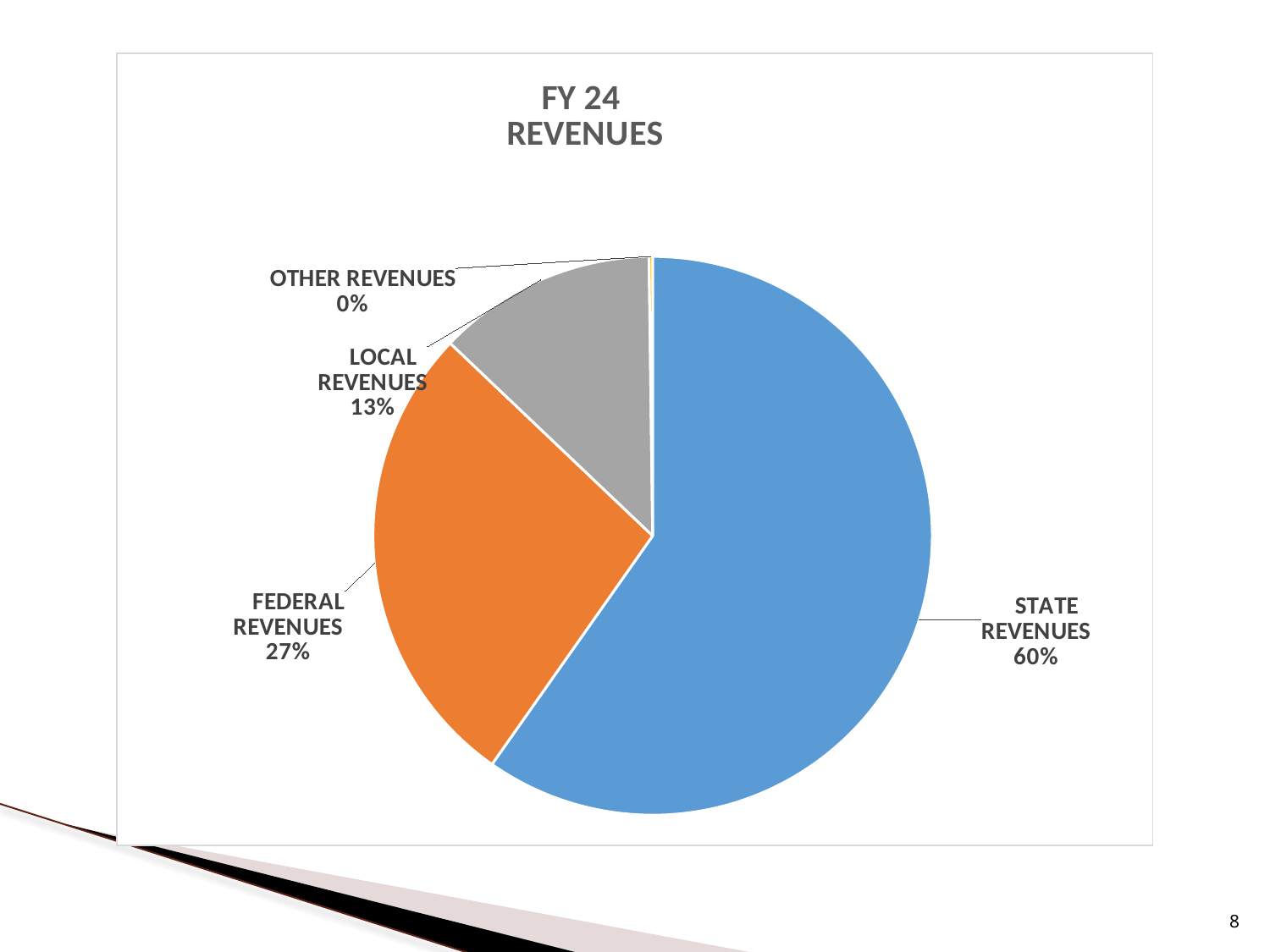
Which revenue category has the smallest share of the pie? OTHER REVENUES What share of FY 24 revenues comes from FEDERAL REVENUES? 27% What is the title of the chart? FY 24 REVENUES What share of FY 24 revenues comes from STATE REVENUES? 60% What kind of chart is shown on the slide? pie chart How many percentage points larger is STATE REVENUES than FEDERAL REVENUES? 33 What is the difference in percentage points between FEDERAL REVENUES and LOCAL REVENUES? 14 Which is larger, FEDERAL REVENUES or LOCAL REVENUES? FEDERAL REVENUES How many revenue categories are shown in the pie chart? 4 What percentage is shown for OTHER REVENUES? 0% Which revenue category has the largest share of the pie? STATE REVENUES What share of FY 24 revenues comes from LOCAL REVENUES? 13%